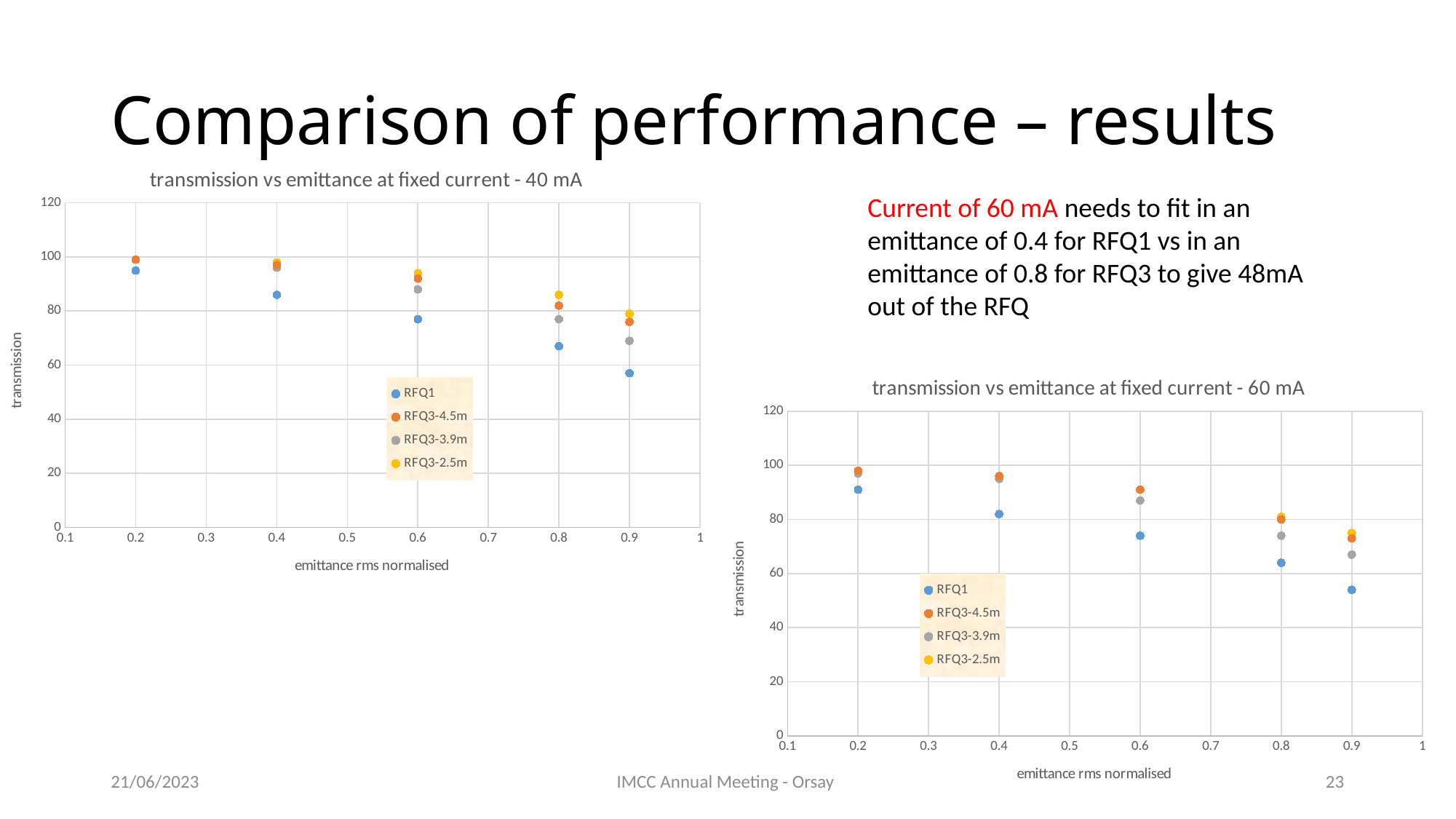
What is the x-axis label of the 'transmission vs emittance at fixed current - 60 mA' chart? emittance rms normalised In the 'transmission vs emittance at fixed current - 40 mA' chart, at emittance 0.6, which has the higher transmission: RFQ1 or RFQ3-2.5m? RFQ3-2.5m How many series does the legend of the 'transmission vs emittance at fixed current - 60 mA' chart list? 4 In the 'transmission vs emittance at fixed current - 60 mA' chart, is the RFQ3-4.5m transmission at emittance 0.2 greater or less than 80? greater In the 'transmission vs emittance at fixed current - 60 mA' chart, at emittance 0.8, which has the higher transmission: RFQ1 or RFQ3-3.9m? RFQ3-3.9m What is the title of the chart on the right side of the slide? transmission vs emittance at fixed current - 60 mA In the 'transmission vs emittance at fixed current - 60 mA' chart, does the RFQ1 transmission rise or fall as emittance increases? fall In the 'transmission vs emittance at fixed current - 40 mA' chart, which series has the lowest transmission at emittance 0.9? RFQ1 What kind of chart is the 'transmission vs emittance at fixed current - 40 mA' chart? scatter chart In the 'transmission vs emittance at fixed current - 40 mA' chart, is the RFQ1 transmission at emittance 0.8 greater or less than 80? less In the 'transmission vs emittance at fixed current - 60 mA' chart, is the RFQ1 transmission at emittance 0.9 greater or less than 60? less In the 'transmission vs emittance at fixed current - 40 mA' chart, how many data points are plotted for the RFQ1 series? 5